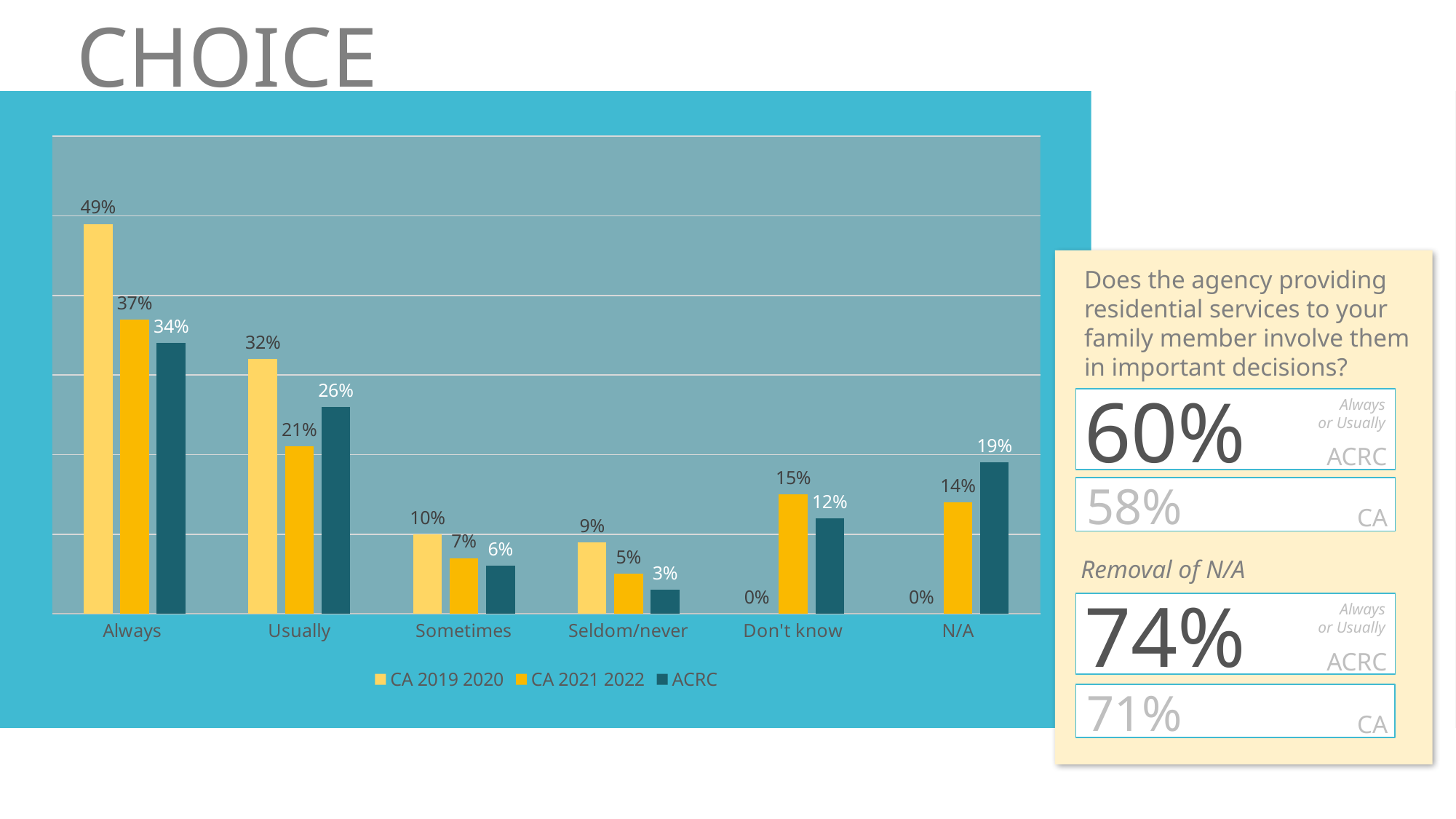
Which category has the highest value for the ACRC series? Always What is the CA 2021 2022 value for Don't know? 15% Which category has the lowest value for the CA 2021 2022 series? Seldom/never Which is larger for the Usually category: CA 2021 2022 or ACRC? ACRC What is the ACRC value for the Usually category? 26% How many series does the legend list? 3 What is the value for CA 2019 2020 in the N/A category? 0% What is the difference between the CA 2019 2020 and ACRC values for Always? 15% What is the value for CA 2019 2020 in the Always category? 49% What kind of chart is shown on the slide? Bar chart How many categories are shown on the x axis? 6 What is the ACRC value for N/A? 19%